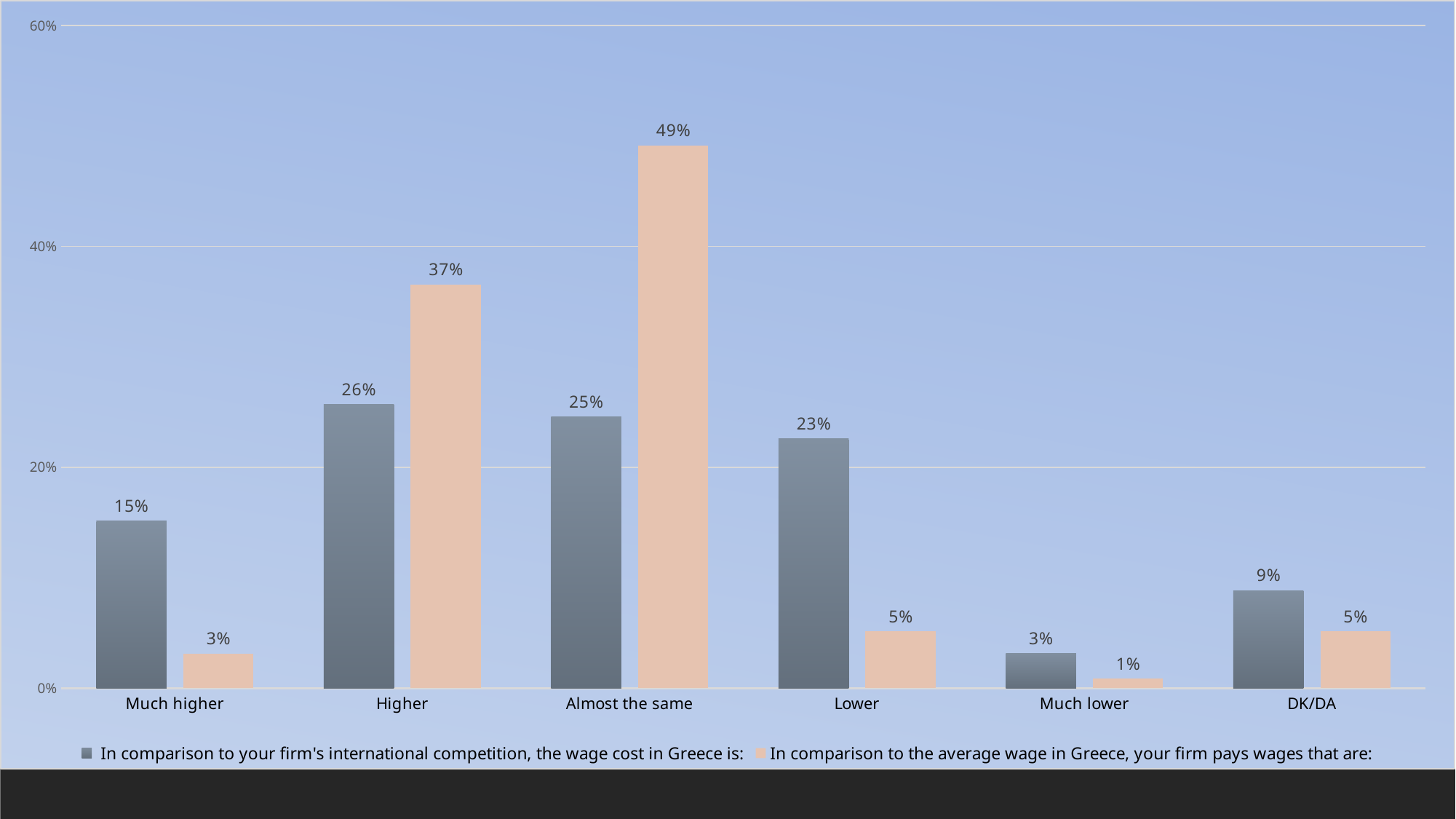
Which category has the lowest value in the series 'In comparison to your firm's international competition, the wage cost in Greece is:'? Much lower How many categories are shown on the x axis? 6 Is the value for 'Higher' in the series 'In comparison to the average wage in Greece, your firm pays wages that are:' greater or less than 40%? less Which category has the highest value in the series 'In comparison to the average wage in Greece, your firm pays wages that are:'? Almost the same What kind of chart is shown on the slide? bar chart What is the value for 'Lower' in the series 'In comparison to your firm's international competition, the wage cost in Greece is:'? 23% What is the difference between the two series' values for 'Almost the same'? 24% What is the value for 'Almost the same' in the series 'In comparison to the average wage in Greece, your firm pays wages that are:'? 49% What is the value for 'Much higher' in the series 'In comparison to your firm's international competition, the wage cost in Greece is:'? 15% What is the difference between the two series' values for 'Higher'? 11% How many series does the legend list? 2 For 'Lower', which series has the larger value? In comparison to your firm's international competition, the wage cost in Greece is: